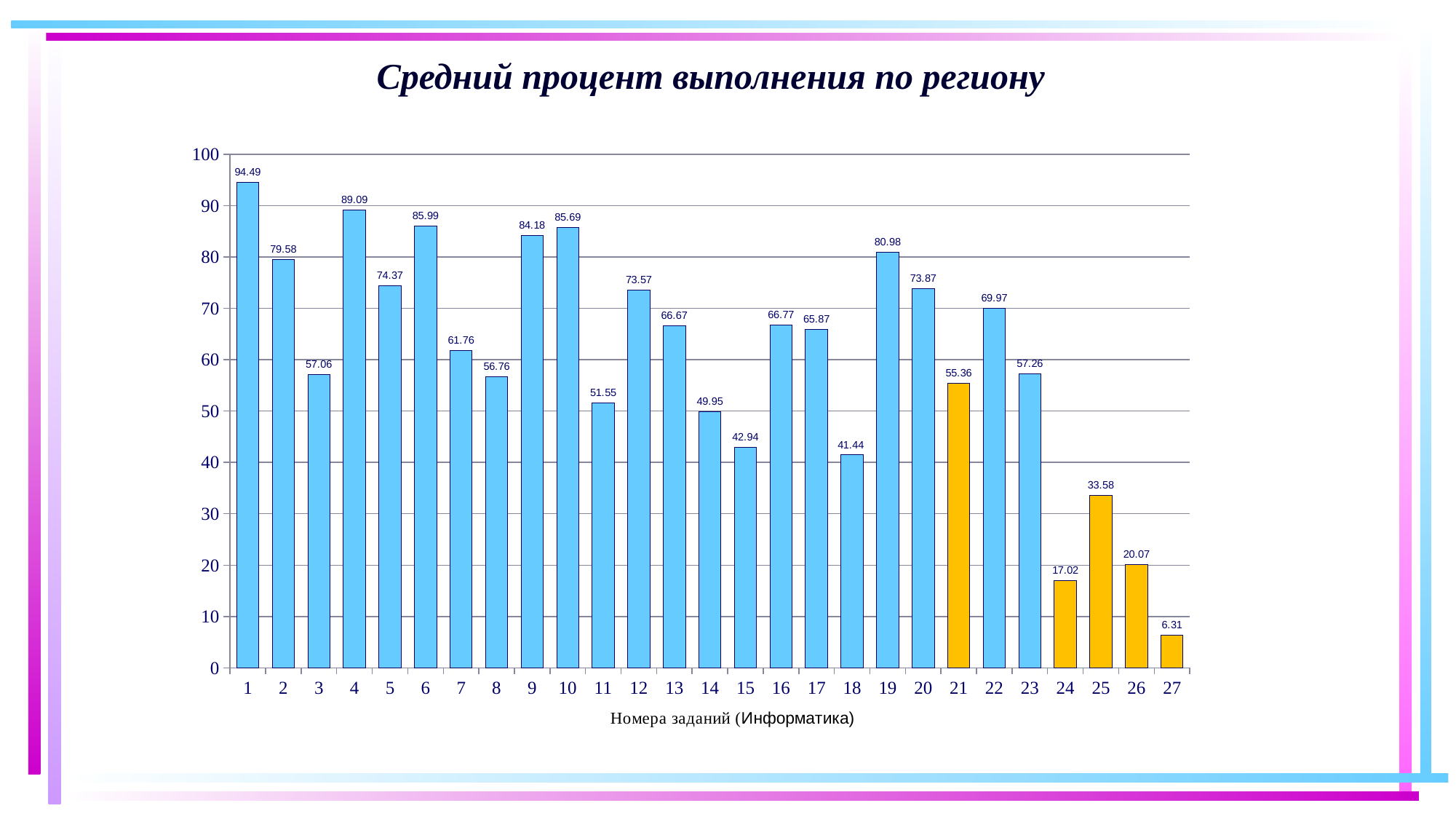
What is the value for task 1? 94.49 What is the value for task 27? 6.31 Which has a larger value, task 9 or task 10? task 10 What is the value for task 19? 80.98 Which task numbers are shown with orange bars? 21, 24, 25, 26, 27 Which task number has the highest value? 1 Which task number has the lowest value? 27 What is the difference between the values for task 4 and task 3? 32.03 How many task numbers are shown on the x axis? 27 Is the value for task 14 greater or less than 50? less What is the title of the chart? Средний процент выполнения по региону What kind of chart is shown on the slide? bar chart